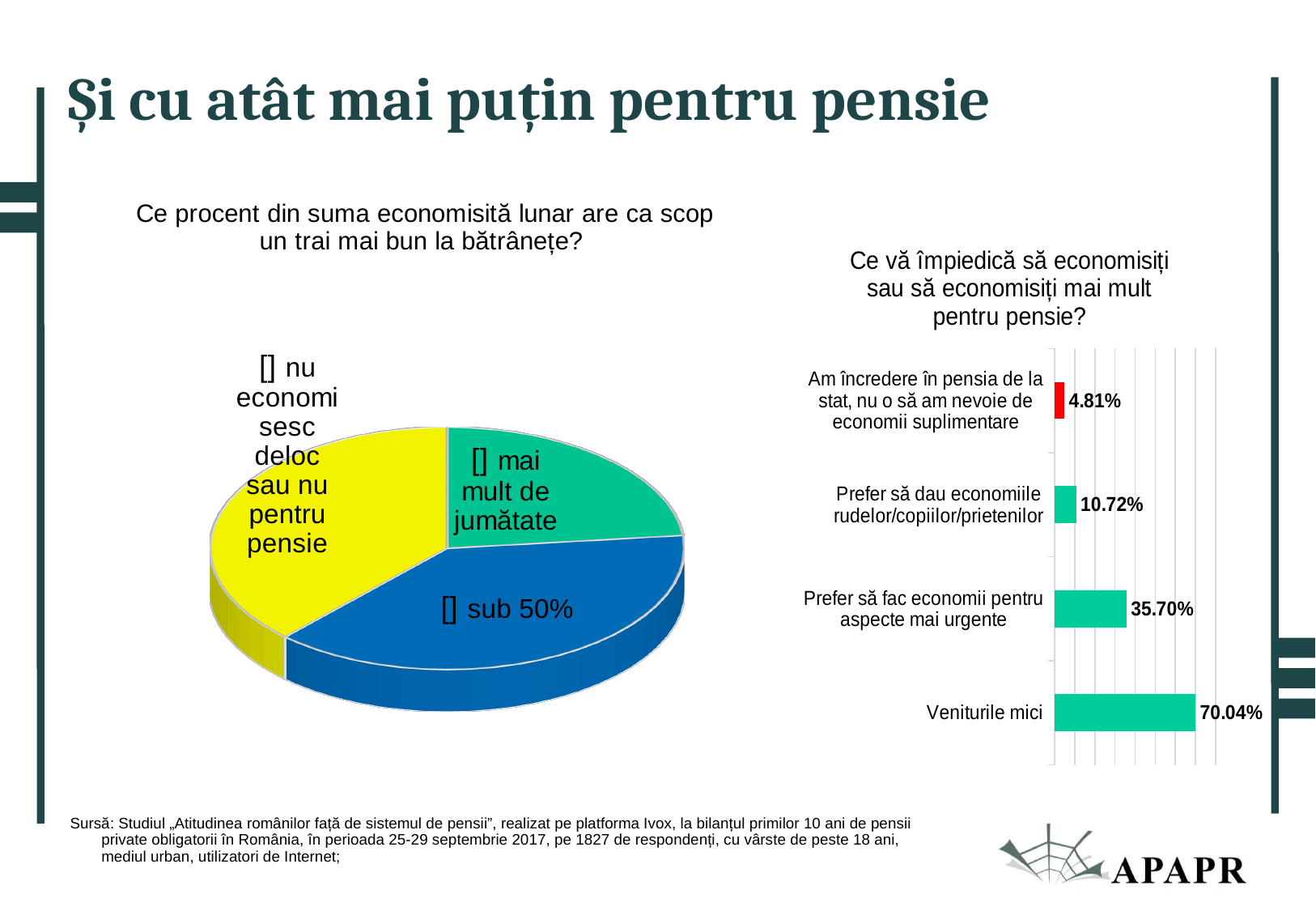
In the bar chart on the right, what is the value for "Am încredere în pensia de la stat, nu o să am nevoie de economii suplimentare"? 4.81% In the pie chart on the left, which slice is the smallest? mai mult de jumătate What kind of chart is the chart on the left of the slide? Pie chart In the bar chart on the right, what is the value for "Prefer să dau economiile rudelor/copiilor/prietenilor"? 10.72% In the bar chart on the right, which is larger: the value for "Prefer să dau economiile rudelor/copiilor/prietenilor" or the value for "Am încredere în pensia de la stat, nu o să am nevoie de economii suplimentare"? Prefer să dau economiile rudelor/copiilor/prietenilor In the bar chart on the right, what is the value for "Veniturile mici"? 70.04% How many categories does the bar chart on the right show? 4 In the bar chart on the right, which category has the highest value? Veniturile mici In the bar chart on the right, which category has the lowest value? Am încredere în pensia de la stat, nu o să am nevoie de economii suplimentare In the bar chart on the right, what is the difference between the values for "Veniturile mici" and "Prefer să fac economii pentru aspecte mai urgente"? 34.34% In the bar chart on the right, what is the value for "Prefer să fac economii pentru aspecte mai urgente"? 35.70% What kind of chart is the chart on the right of the slide? Bar chart